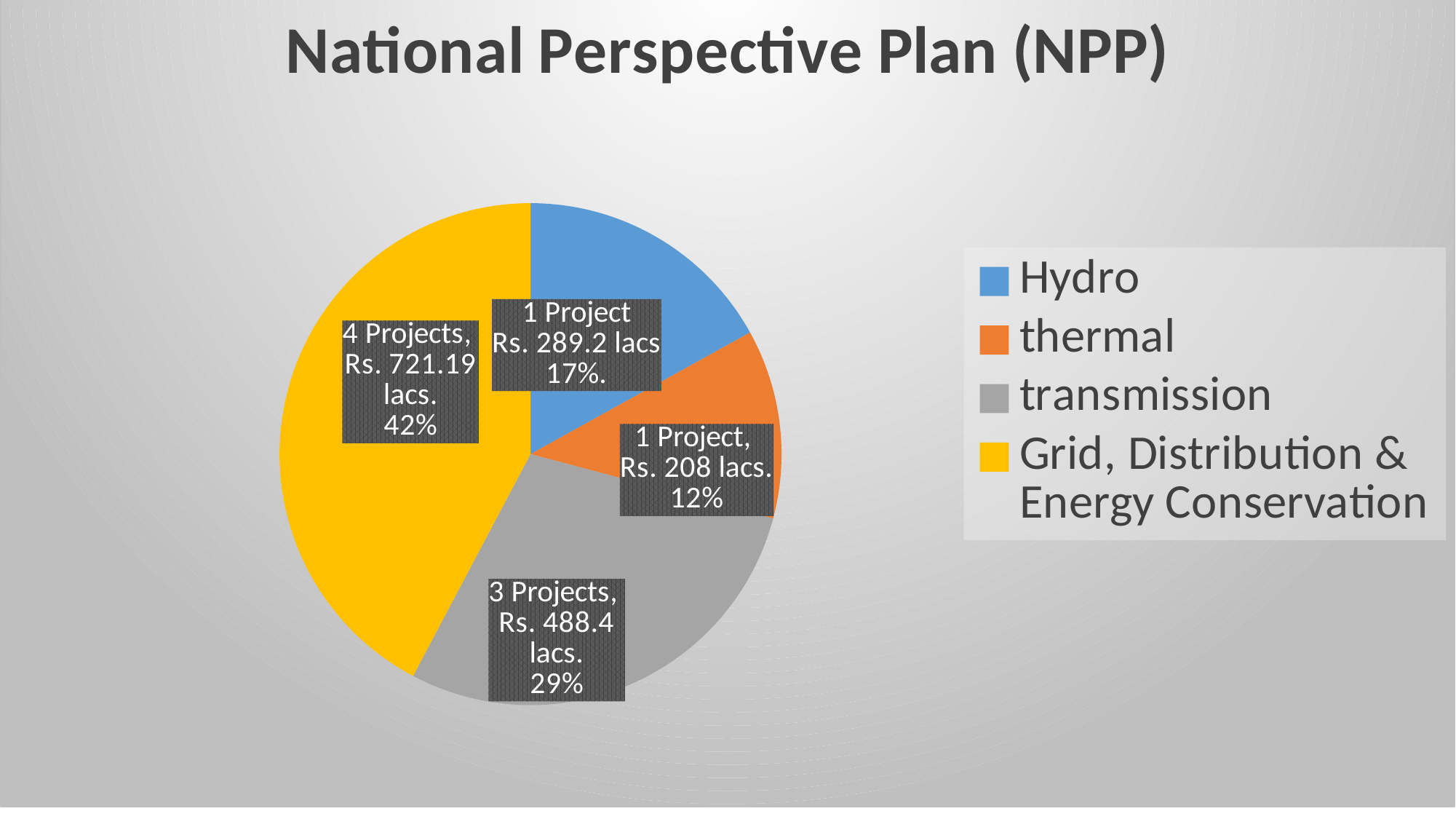
How many projects are shown for transmission? 3 Projects Which has a larger share, Hydro or transmission? transmission What is the difference in percentage share between Grid, Distribution & Energy Conservation and thermal? 30% How many slices does the pie chart have? 4 What share of the pie does Hydro represent? 17% What is the amount shown for Grid, Distribution & Energy Conservation? Rs. 721.19 lacs What is the amount shown for thermal? Rs. 208 lacs Which category has the smallest share of the pie? thermal Which category has the largest share of the pie? Grid, Distribution & Energy Conservation What is the title of the chart? National Perspective Plan (NPP) What share of the pie does transmission represent? 29% What kind of chart is shown on the slide? pie chart